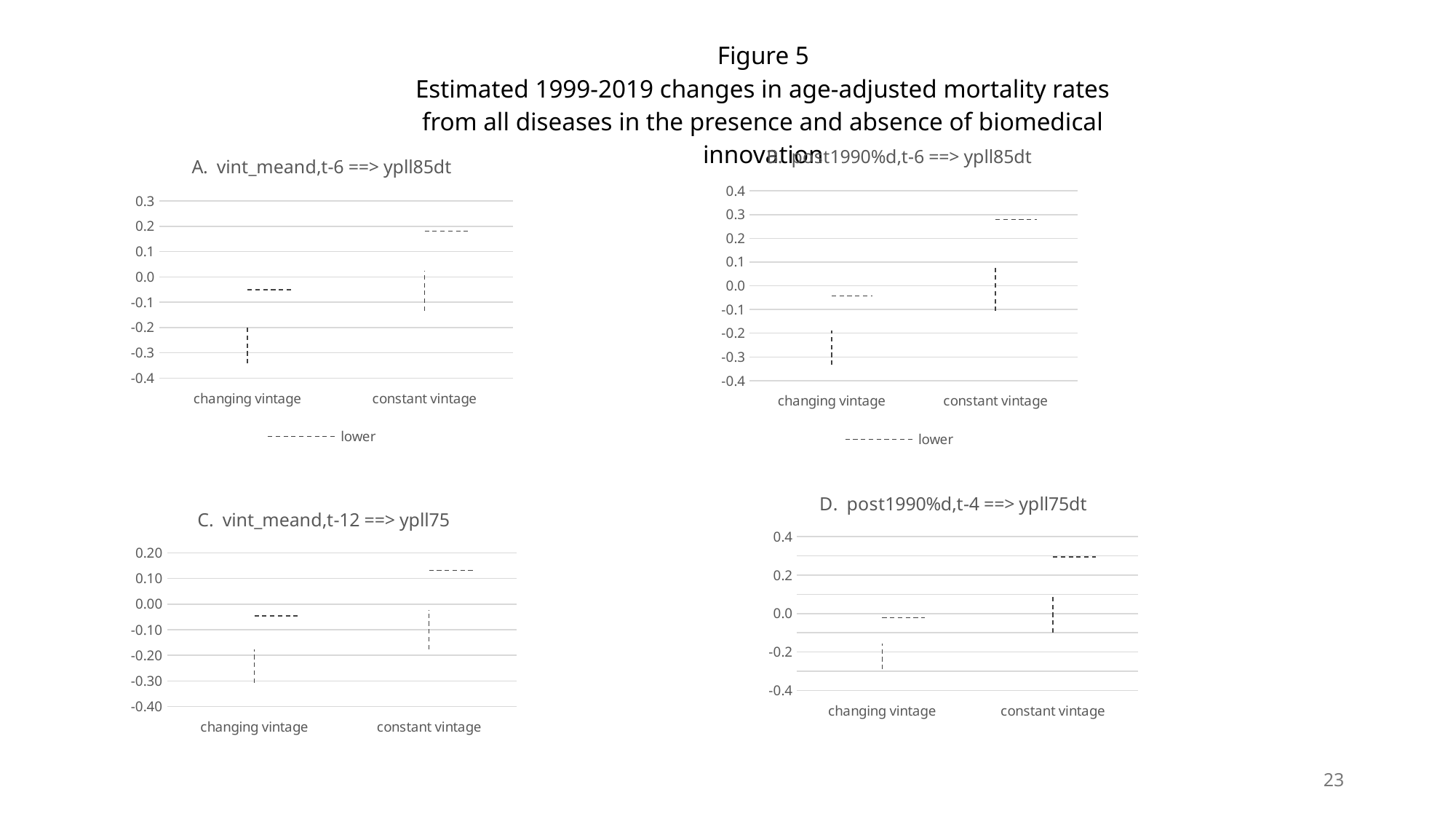
How many categories are shown on the x axis of chart C (vint_meand,t-12 ==> ypll75)? 2 In chart D (post1990%d,t-4 ==> ypll75dt), which category has the higher value, changing vintage or constant vintage? constant vintage In chart C (vint_meand,t-12 ==> ypll75), is the value for changing vintage greater or less than 0.00? less What is the legend entry shown below chart A (vint_meand,t-6 ==> ypll85dt)? lower How many charts are shown on the slide? 4 In chart B (top right, post1990%d,t-6 ==> ypll85dt), which category has the lower value, changing vintage or constant vintage? changing vintage In chart A (vint_meand,t-6 ==> ypll85dt), is the value for changing vintage greater or less than 0.0? less In chart A (vint_meand,t-6 ==> ypll85dt), which category has the higher value, changing vintage or constant vintage? constant vintage